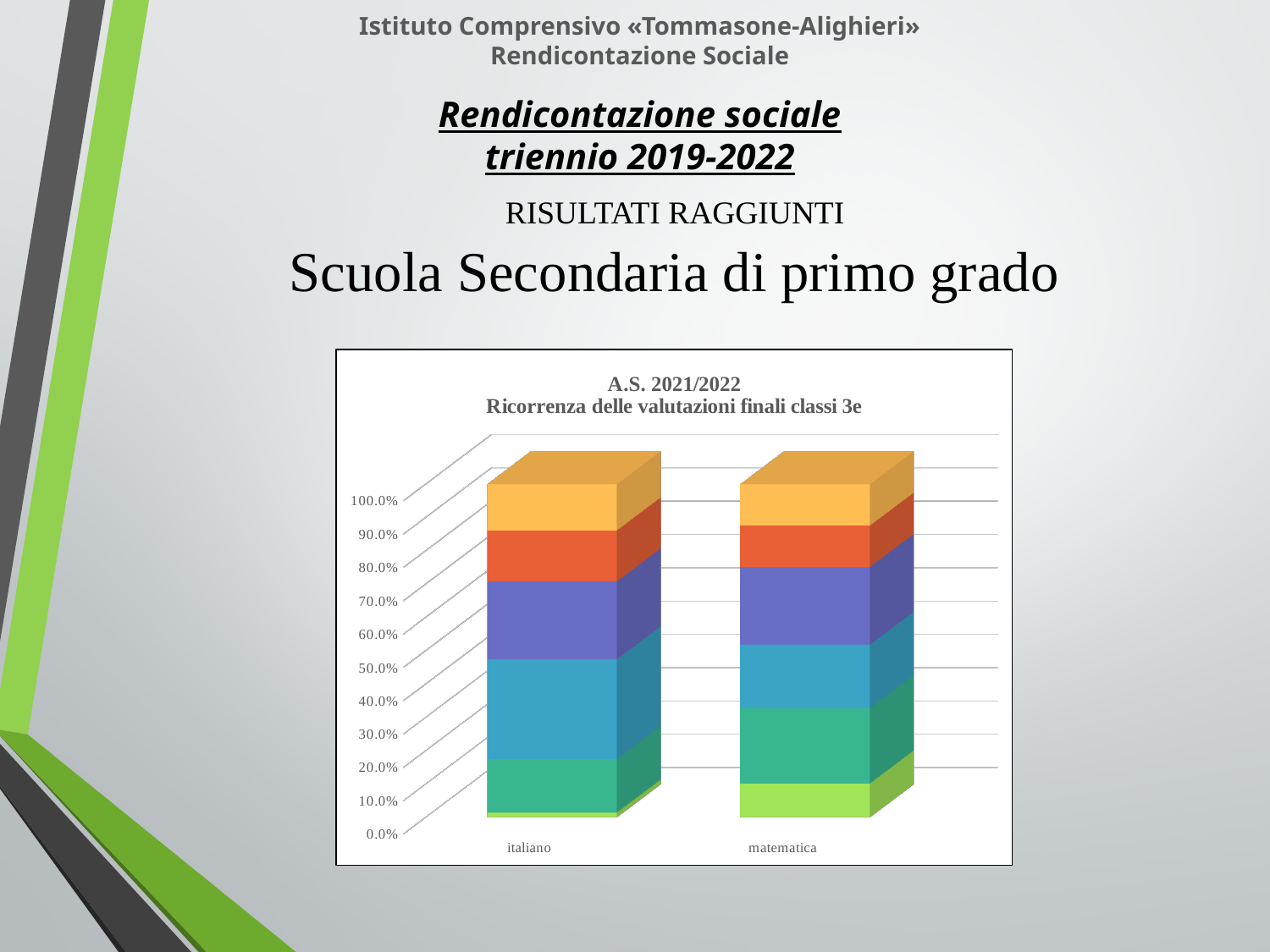
How many categories are shown on the x axis of the chart? 2 Which bar has the larger green segment (second from the bottom), italiano or matematica? matematica What is the title of the chart? A.S. 2021/2022 Ricorrenza delle valutazioni finali classi 3e Is the top of the blue segment in the italiano bar greater or less than 40%? greater What is the highest value shown on the vertical axis of the chart? 100.0% Which bar has the larger blue segment (third from the bottom), italiano or matematica? italiano What are the two categories on the x axis of the chart? italiano and matematica Is the top of the green segment in the matematica bar greater or less than 20%? greater Is the bottom (light green) segment of the italiano bar greater or less than 10%? less What kind of chart is shown on the slide? stacked bar chart Which bar has the larger bottom (light green) segment, italiano or matematica? matematica